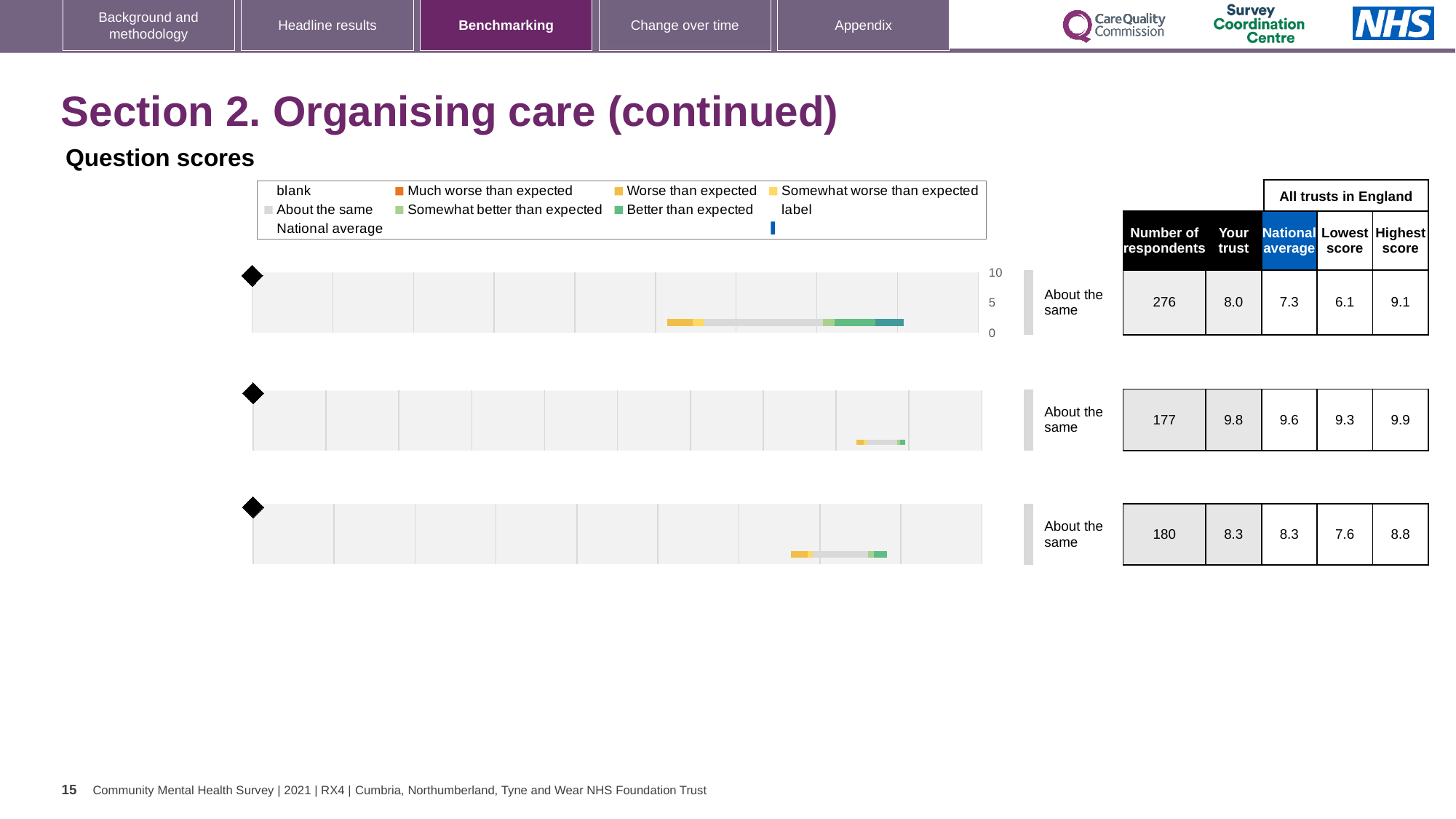
For the top chart row, what is the difference between the 'Your trust' score and the national average? 0.7 For the top chart row, what is the 'Your trust' score shown in the table? 8.0 What benchmark category is given for all three chart rows? About the same Which chart row has the lowest 'Lowest score' value in the table? the top row (6.1) What kind of chart is used for the three benchmarking rows on the slide? bar chart For the bottom chart row, is the 'Your trust' score larger than the national average? No, they are equal (8.3) For the middle chart row, what is the national average shown in the table? 9.6 Which chart row has the highest 'Your trust' score? the middle row (9.8) How many benchmarking bar charts are shown on the slide? 3 In the chart legend, which colour represents 'Much worse than expected'? orange For the bottom chart row, what is the number of respondents? 180 What is the maximum value shown on the axis of the top chart? 10